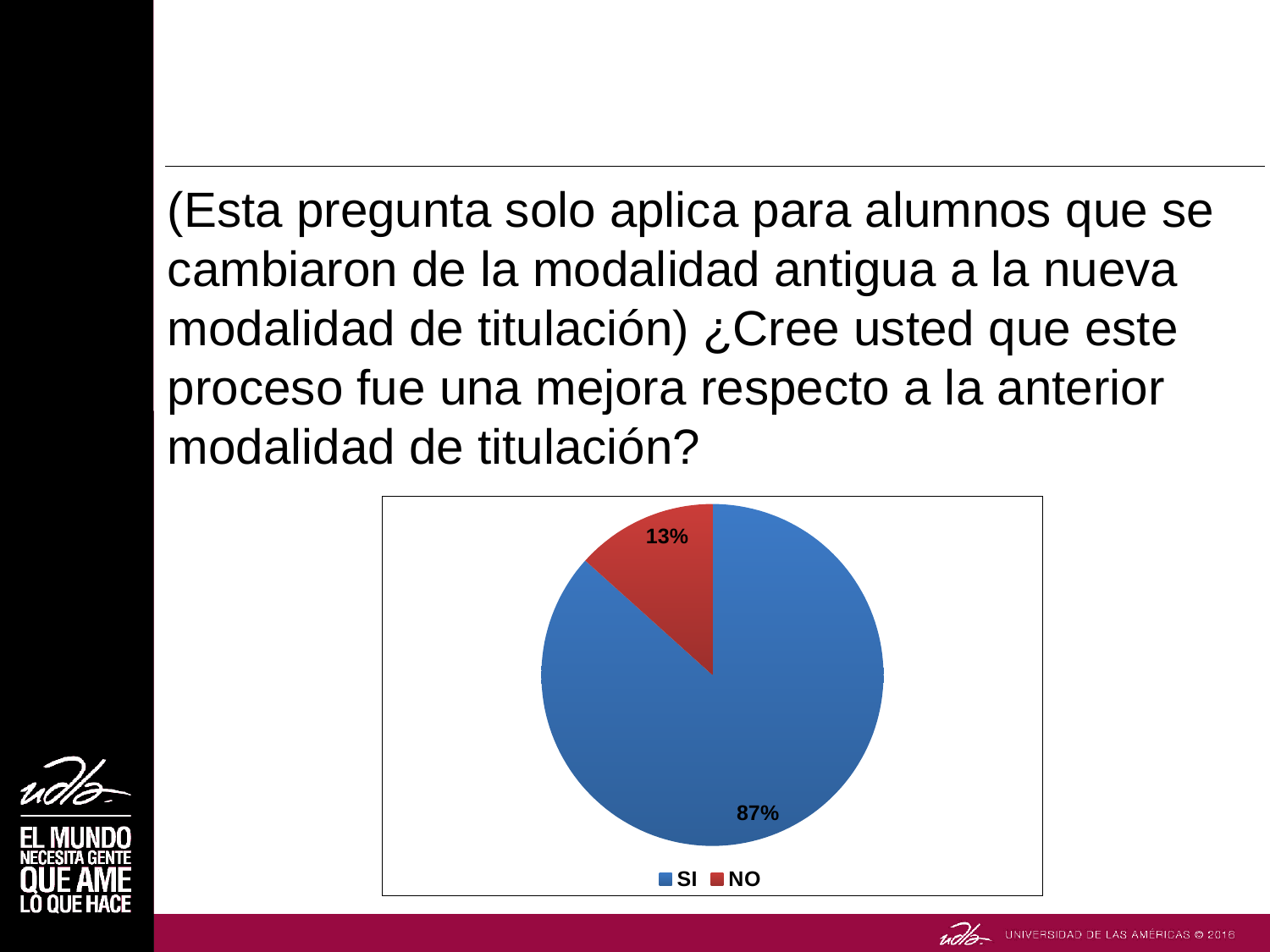
How many entries does the legend list? 2 What colour is the NO slice in the pie chart? red What percentage of the pie chart corresponds to SI? 87% What colour is the SI slice in the pie chart? blue Which category has the smallest share of the pie chart? NO What is the difference in percentage points between the SI and NO slices? 74 Which slice is larger, SI or NO? SI What share of the pie does the NO slice represent? 13% How many slices does the pie chart have? 2 What percentage of the pie chart corresponds to NO? 13% Which category has the largest share of the pie chart? SI What kind of chart is shown on the slide? pie chart